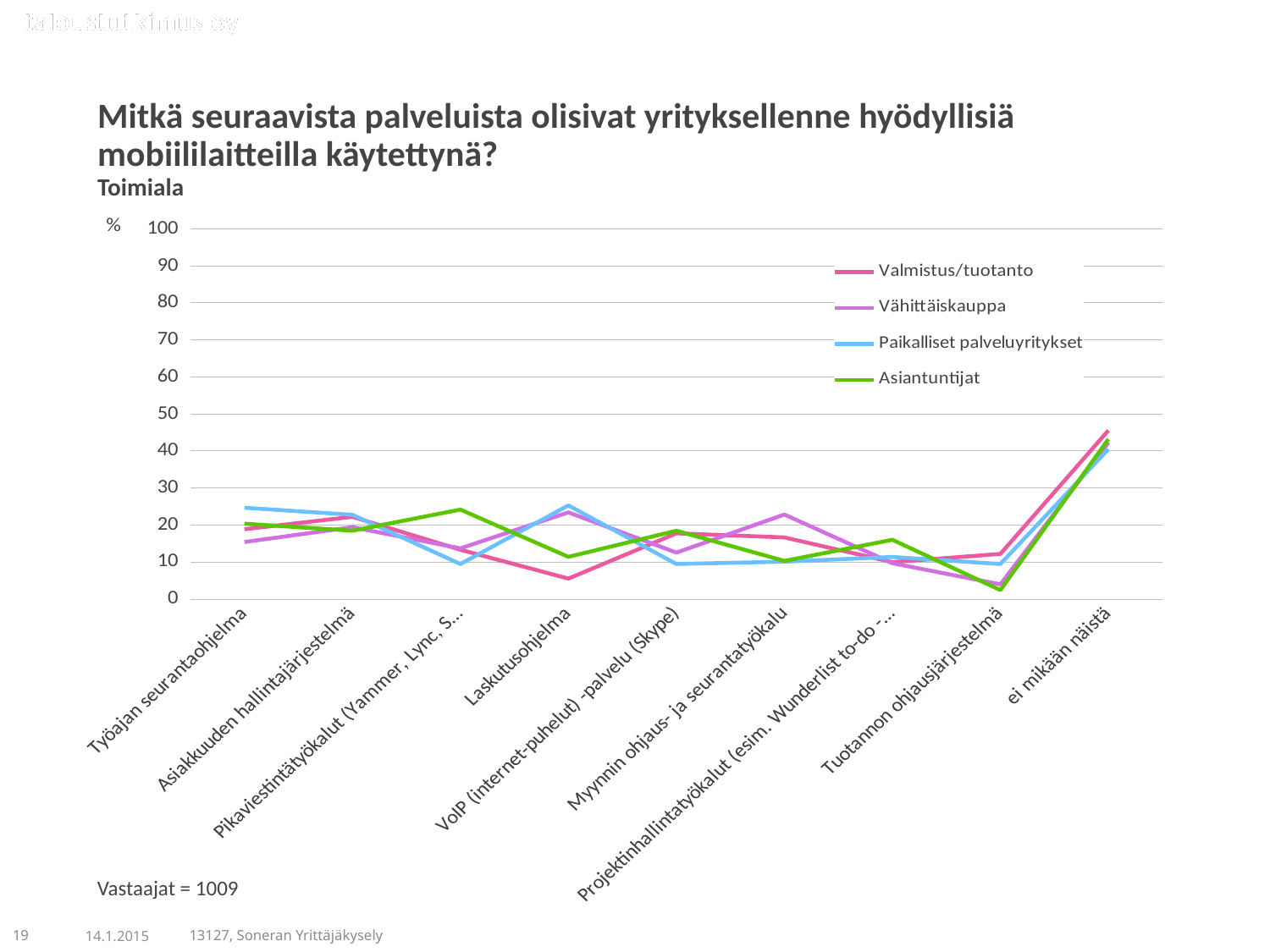
Is the value for Vähittäiskauppa at ei mikään näistä greater or less than 30? greater Is the value for Asiantuntijat at Pikaviestintätyökalut greater or less than 20? greater For the Asiantuntijat series, which category has the lowest value? Tuotannon ohjausjärjestelmä For the Valmistus/tuotanto series, which category has the highest value? ei mikään näistä How many categories are shown along the x axis of the chart? 9 What kind of chart is shown on the slide? line chart How many series does the chart's legend list? 4 At Pikaviestintätyökalut, which series has the larger value: Asiantuntijat or Paikalliset palveluyritykset? Asiantuntijat Is the value for Paikalliset palveluyritykset at Työajan seurantaohjelma greater or less than 20? greater What colour is the line for the Asiantuntijat series? green At Laskutusohjelma, which series has the larger value: Vähittäiskauppa or Valmistus/tuotanto? Vähittäiskauppa